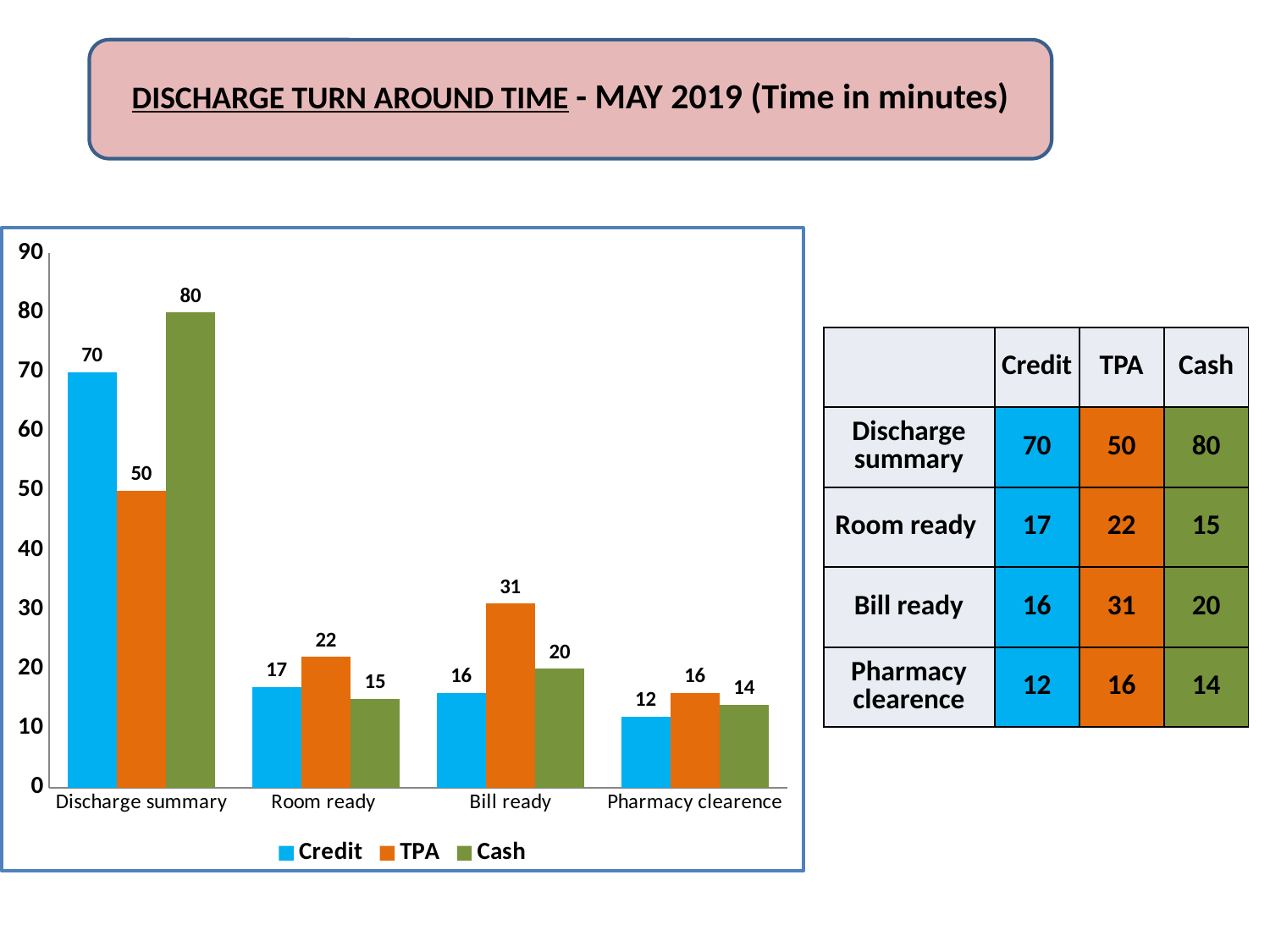
What is the difference between the Cash and TPA values for Discharge summary? 30 How many categories are shown on the x axis? 4 Which category has the lowest Credit value? Pharmacy clearence What is the Cash value for Pharmacy clearence? 14 What kind of chart is shown on the slide? bar chart Is the Credit value for Discharge summary greater or less than 60? greater Which category has the highest Cash value? Discharge summary What is the Credit value for Discharge summary? 70 How many series does the legend list? 3 What colour represents the TPA series in the chart? orange Which is larger for Room ready, the TPA value or the Cash value? TPA What is the TPA value for Bill ready? 31